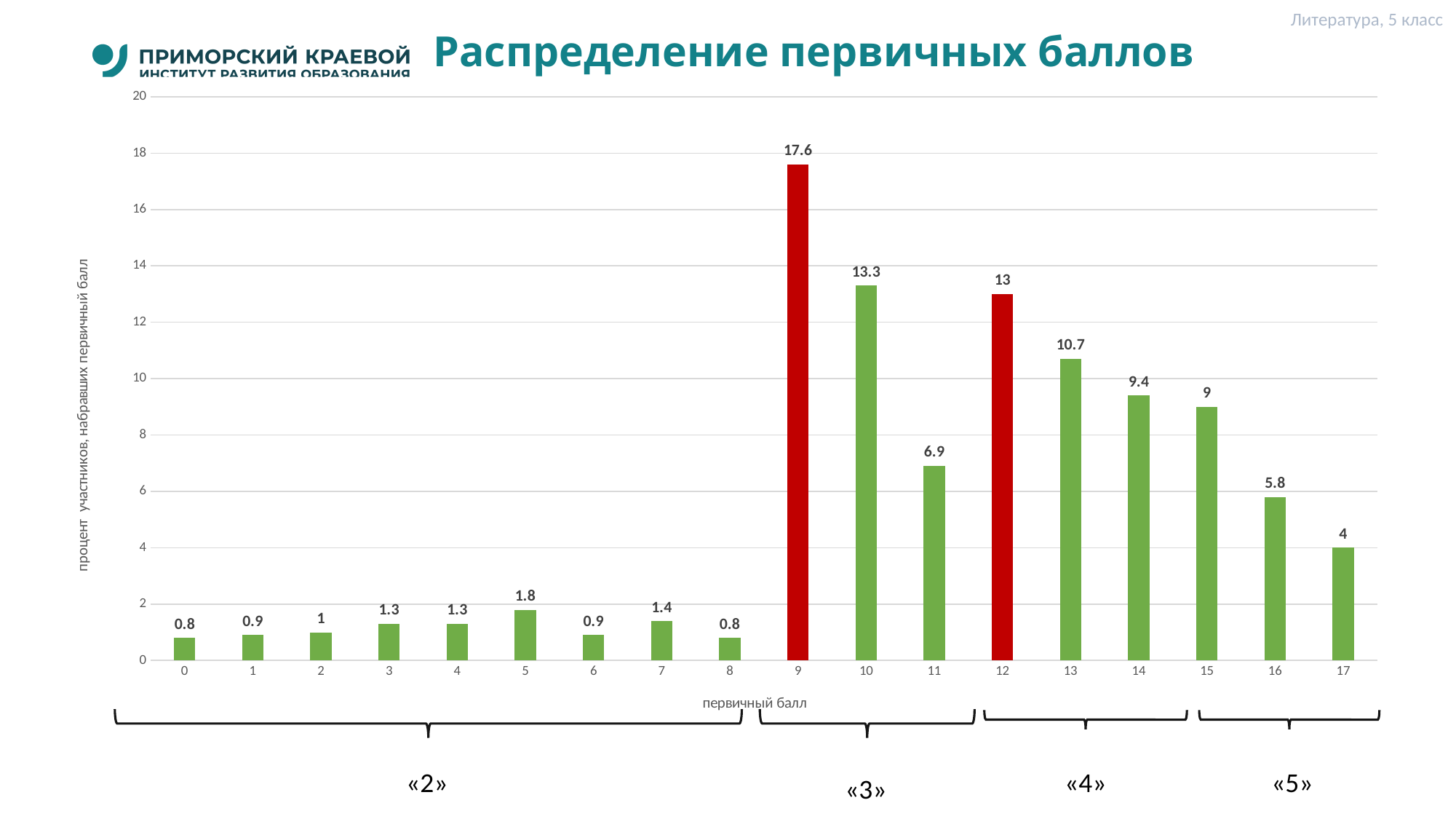
What is the value for primary score 17? 4 Do the values rise or fall along the x axis from primary score 12 to 17? fall What is the difference between the values for primary scores 9 and 10? 4.3 What is the difference between the values for primary scores 12 and 14? 3.6 What is the value for primary score 13? 10.7 Which primary score has the highest value? 9 What is the value for primary score 9? 17.6 Which primary scores are shown with red bars? 9 and 12 How many primary score categories are shown on the x axis? 18 Which is larger, the value for primary score 11 or primary score 16? 11 What kind of chart is shown on the slide? bar chart Is the value for primary score 15 greater or less than 8? greater